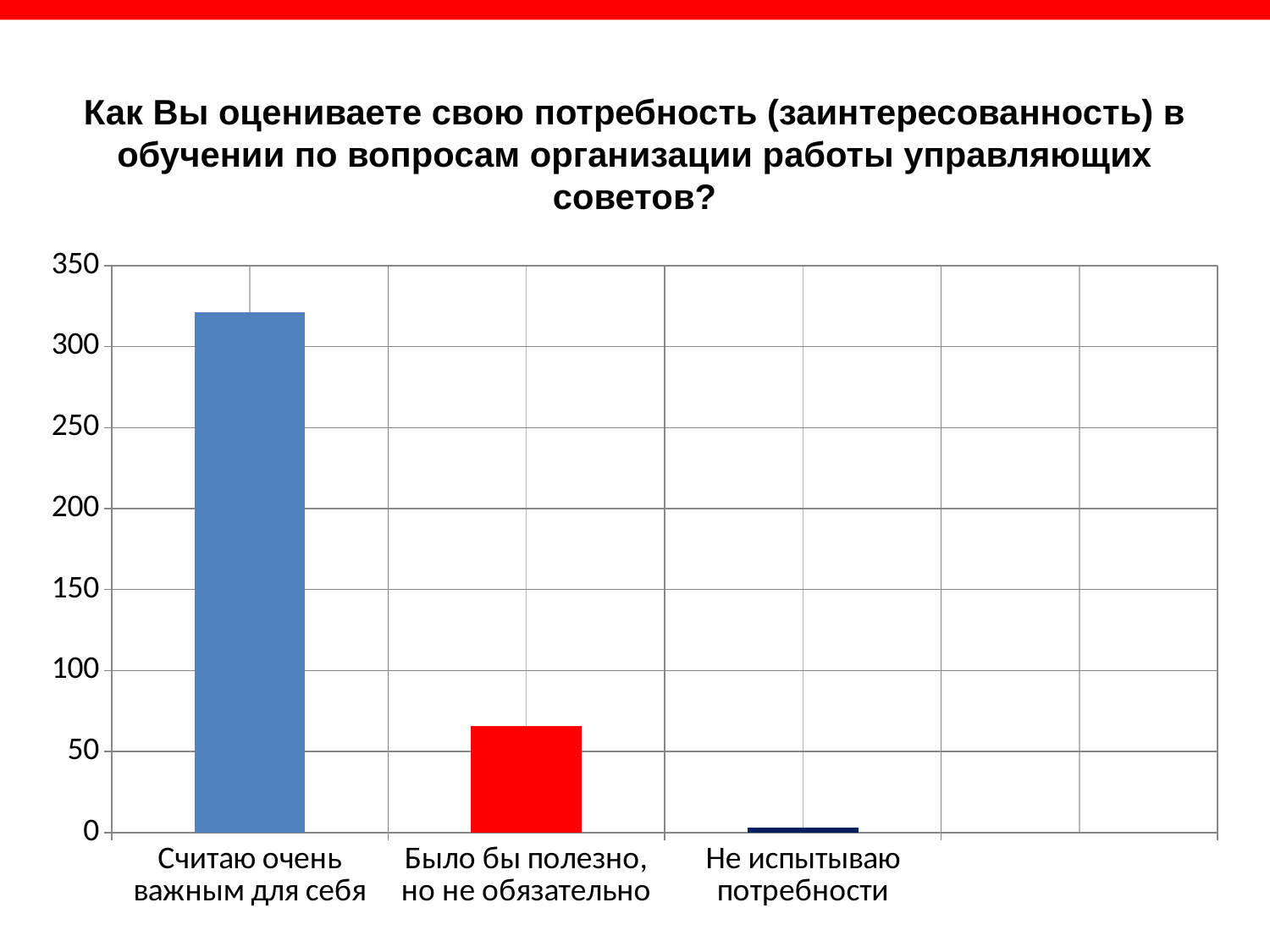
Is the value for "Было бы полезно, но не обязательно" greater or less than 100? less How many categories are shown on the x axis of the chart? 3 What kind of chart is shown on the slide? bar chart Do the values rise or fall from left to right along the x axis? fall What is the highest value shown on the vertical axis? 350 Is the value for "Было бы полезно, но не обязательно" greater or less than 50? greater Is the value for "Считаю очень важным для себя" greater or less than 300? greater Which category has the lowest value? Не испытываю потребности What colour is the bar for "Было бы полезно, но не обязательно"? red Which is larger: the value for "Считаю очень важным для себя" or the value for "Было бы полезно, но не обязательно"? Считаю очень важным для себя Which category has the highest value? Считаю очень важным для себя